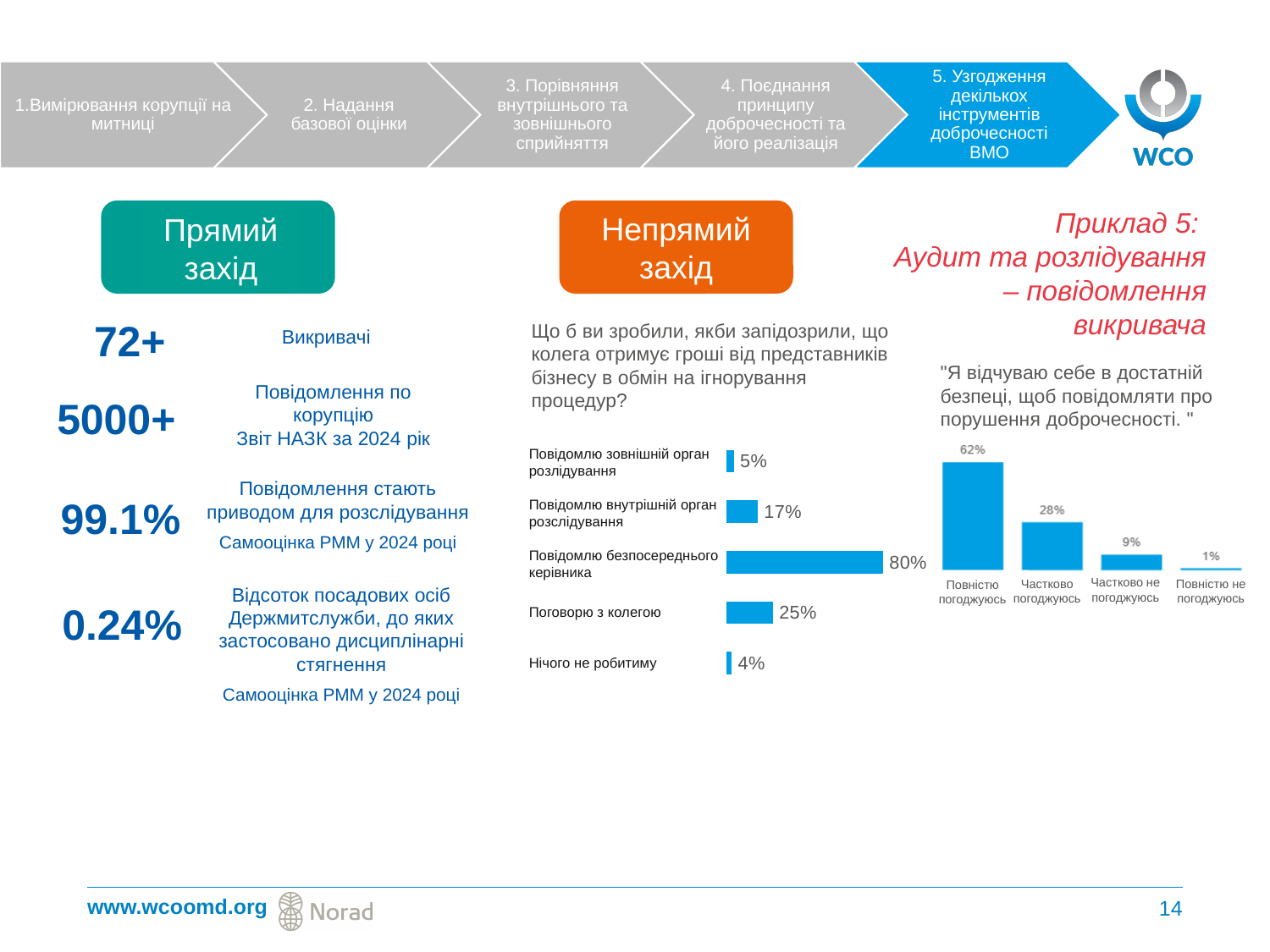
In the horizontal bar chart in the middle of the slide, what is the value for "Повідомлю безпосереднього керівника"? 80% In the horizontal bar chart in the middle of the slide, which category has the highest value? Повідомлю безпосереднього керівника In the vertical bar chart on the right of the slide, what is the value for "Повністю погоджуюсь"? 62% In the vertical bar chart on the right of the slide, what is the value for "Частково не погоджуюсь"? 9% In the horizontal bar chart in the middle of the slide, what is the difference between "Поговорю з колегою" and "Повідомлю внутрішній орган розслідування"? 8% In the horizontal bar chart in the middle of the slide, what is the value for "Поговорю з колегою"? 25% What kind of chart is the one in the middle of the slide? Bar chart In the horizontal bar chart in the middle of the slide, how many categories are shown? 5 In the vertical bar chart on the right of the slide, which category has the lowest value? Повністю не погоджуюсь In the horizontal bar chart in the middle of the slide, which category has the lowest value? Нічого не робитиму In the vertical bar chart on the right of the slide, what is the difference between "Повністю погоджуюсь" and "Частково погоджуюсь"? 34% In the vertical bar chart on the right of the slide, do the values rise or fall from left to right? Fall